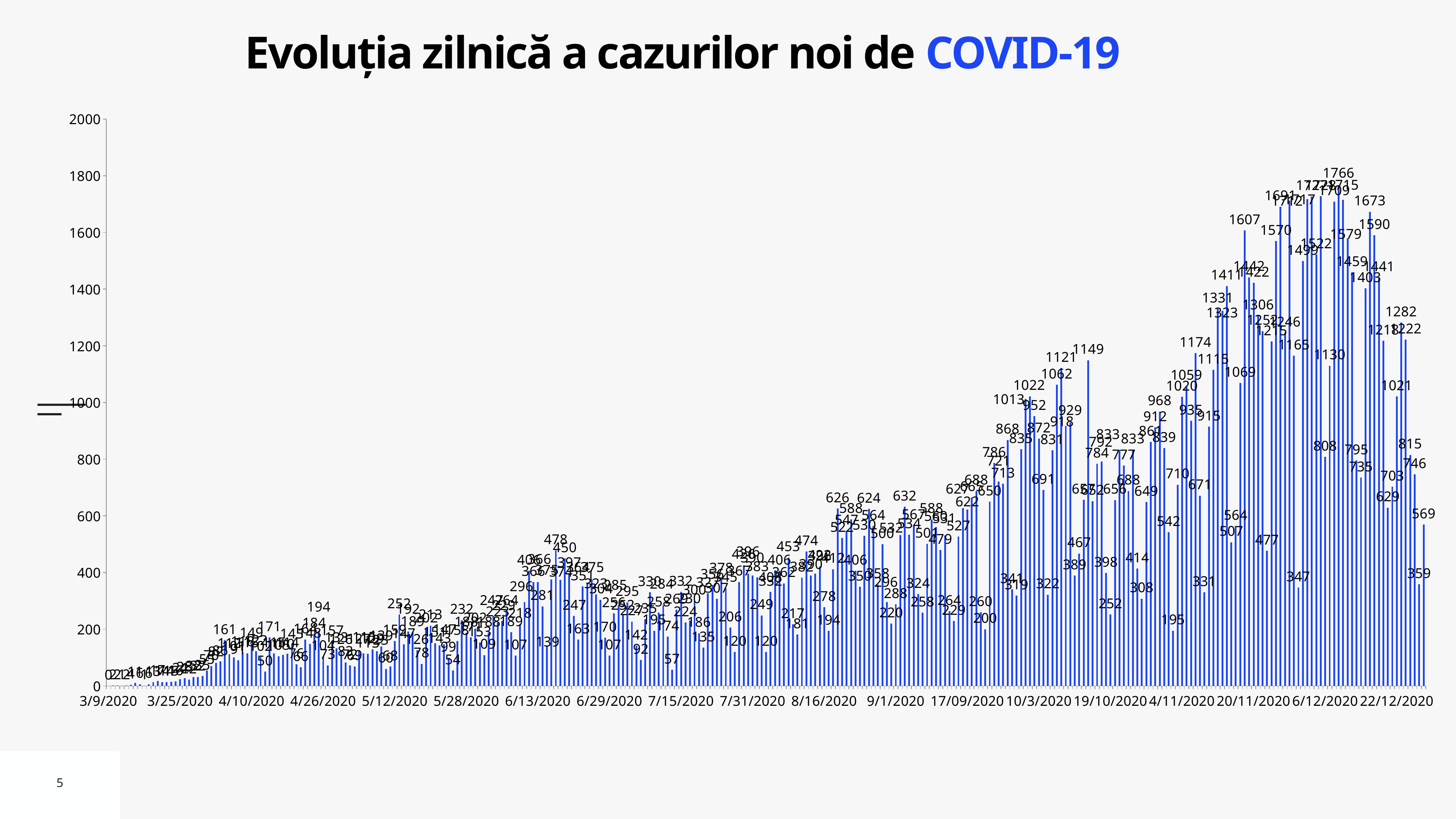
What is the value of the rightmost bar on the chart? 569 Is the value of the bar at 3/9/2020 greater or less than 200? less Is the highest bar on the chart greater or less than 1600? greater Is the highest bar on the chart greater or less than 1800? less What kind of chart is shown on the slide? bar chart What is the title of the chart? Evoluția zilnică a cazurilor noi de COVID-19 What is the last date label on the horizontal axis? 22/12/2020 What is the first date label on the horizontal axis? 3/9/2020 What is the highest value labeled on the chart? 1766 Overall, do the daily values rise or fall from March 2020 to December 2020? rise What is the maximum value shown on the vertical axis? 2000 What is the highest labeled value between 5/28/2020 and 6/29/2020? 478